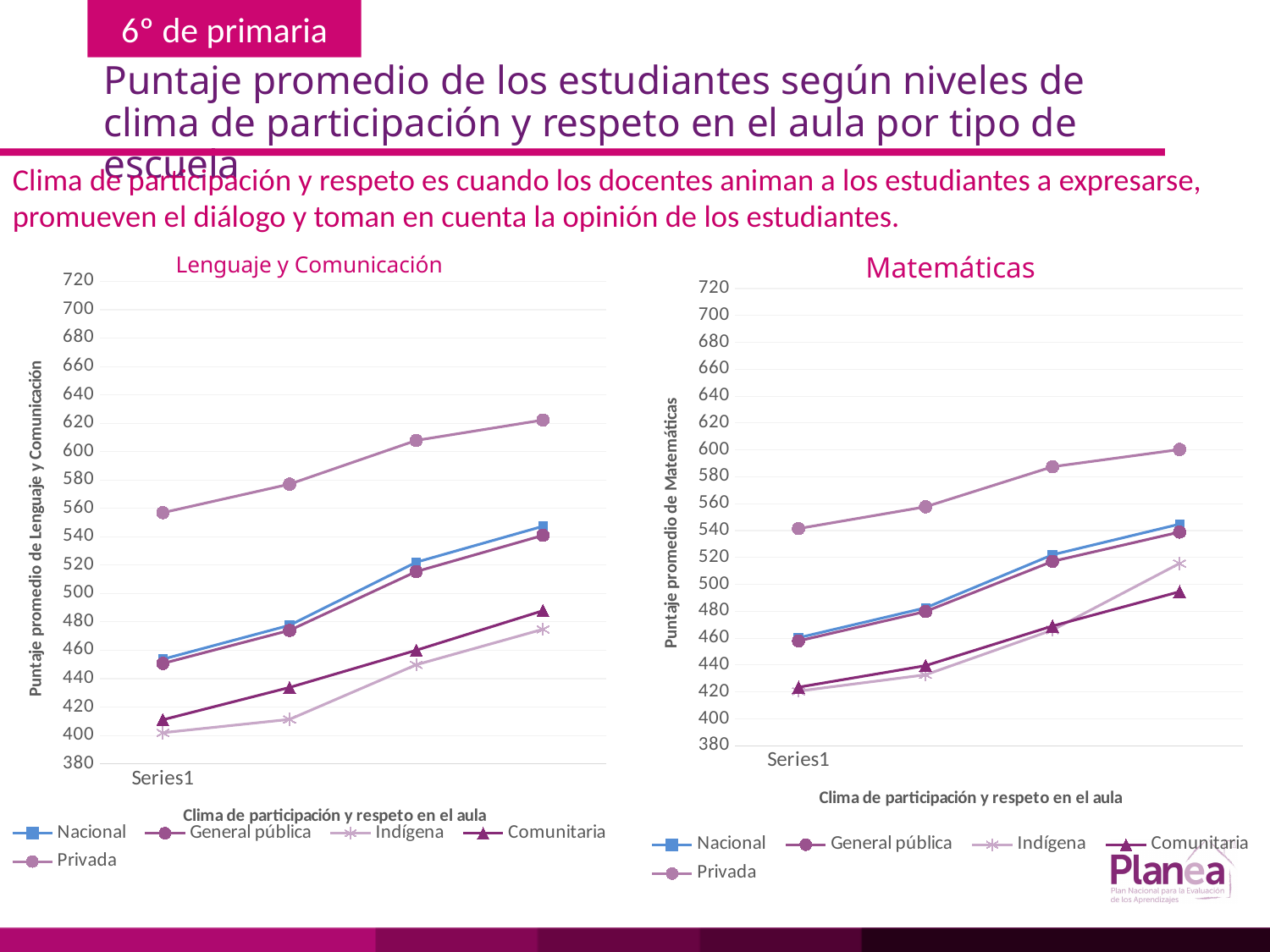
In the Lenguaje y Comunicación chart, is the first value for Privada greater or less than 540? greater In the Matemáticas chart, at the last point, which is higher: Indígena or Comunitaria? Indígena In the Lenguaje y Comunicación chart, is the first value for Indígena greater or less than 420? less In the Matemáticas chart, is the last value for Indígena greater or less than 500? greater How many series does the legend of the Matemáticas chart list? 5 What is the y-axis label of the Matemáticas chart? Puntaje promedio de Matemáticas What kind of chart is the Lenguaje y Comunicación chart? line chart In the Matemáticas chart, which series has the highest values across all points? Privada In the Lenguaje y Comunicación chart, do the values for Privada rise or fall along the x axis? rise How many points does each series have in the Matemáticas chart? 4 In the Lenguaje y Comunicación chart, which series has the highest values across all points? Privada